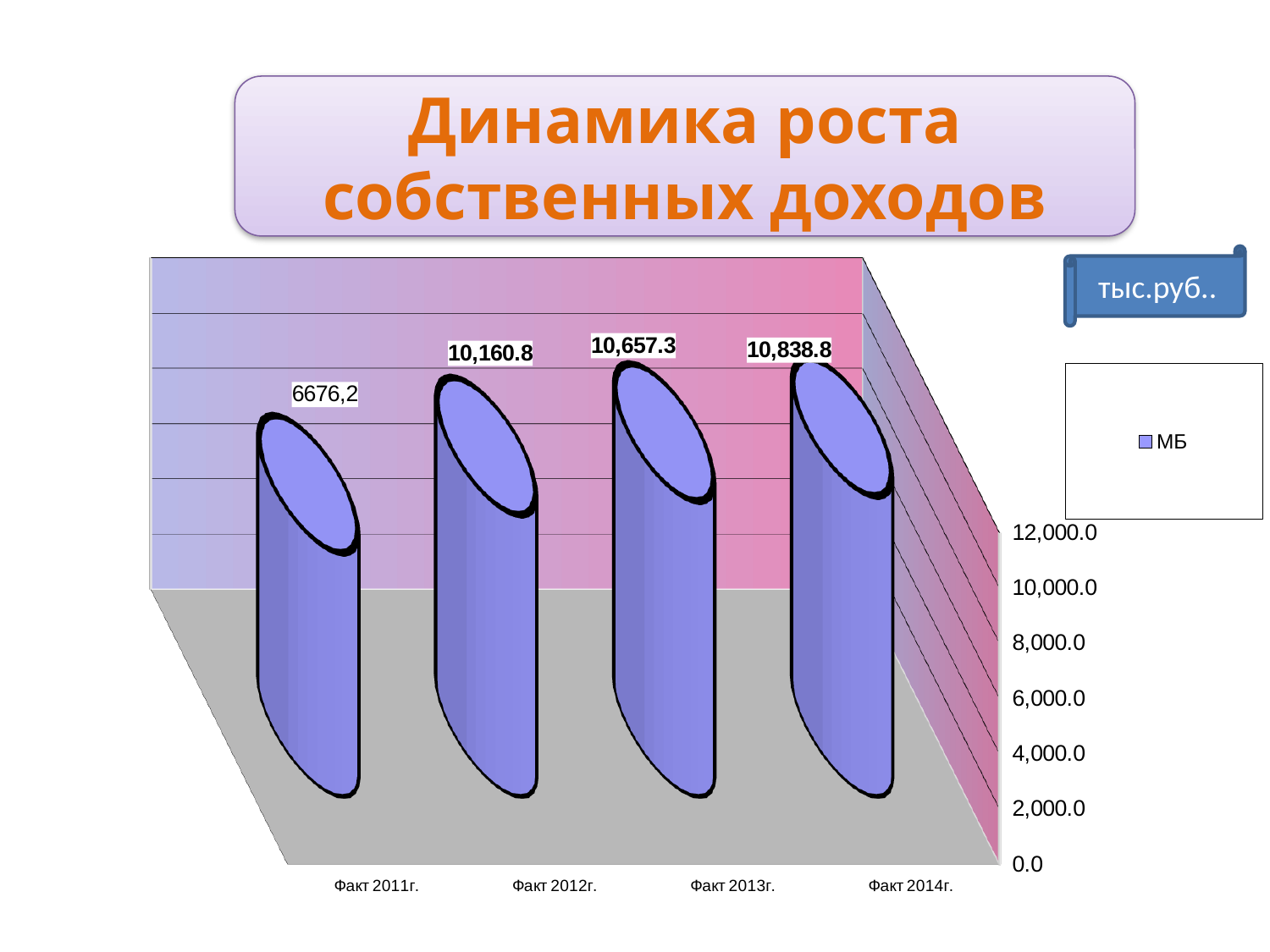
How many categories are shown on the x axis? 4 What is the difference between the values for Факт 2014г. and Факт 2012г.? 678.0 What is the value for Факт 2013г.? 10,657.3 How many series does the legend list? 1 Which is larger, the value for Факт 2013г. or Факт 2012г.? Факт 2013г. What is the value for Факт 2011г.? 6676,2 What is the value for Факт 2014г.? 10,838.8 What is the value for Факт 2012г.? 10,160.8 Which category has the lowest value? Факт 2011г. Do the values rise or fall from Факт 2011г. to Факт 2014г.? rise Which category has the highest value? Факт 2014г.